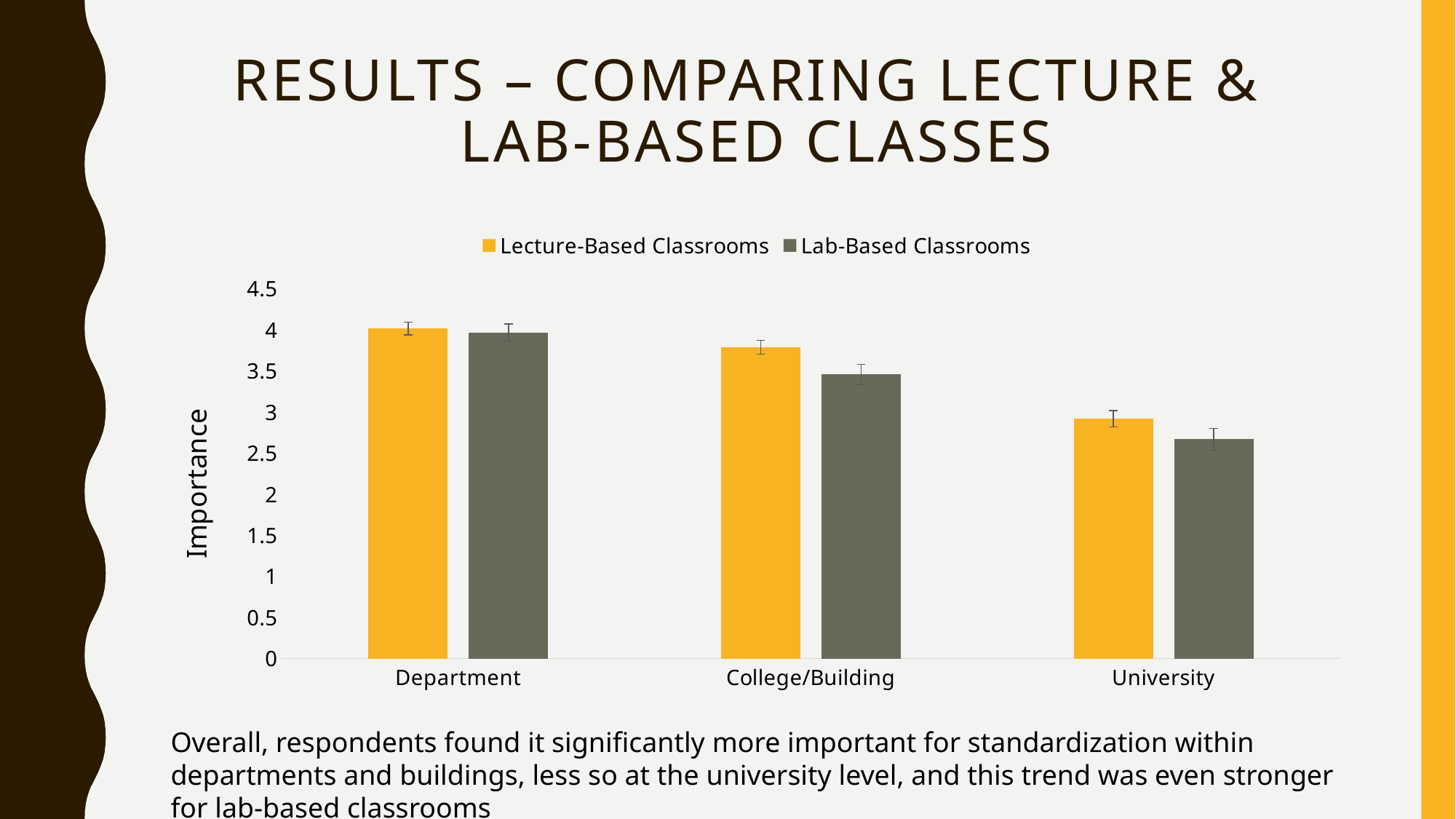
Is the value for Lab-Based Classrooms at College/Building greater or less than 4? less Is the value for Lecture-Based Classrooms at Department greater or less than 3.5? greater Do the Lab-Based Classrooms values rise or fall from Department to University along the x axis? fall Is the value for Lab-Based Classrooms at University greater or less than 3? less Which category has the lowest value for Lab-Based Classrooms? University How many categories are shown on the x axis? 3 Which category has the highest value for Lecture-Based Classrooms? Department For University, which is larger: Lecture-Based Classrooms or Lab-Based Classrooms? Lecture-Based Classrooms For College/Building, which is larger: Lecture-Based Classrooms or Lab-Based Classrooms? Lecture-Based Classrooms What kind of chart is shown on the slide? bar chart How many series does the legend list? 2 What is the label on the vertical axis of the chart? Importance